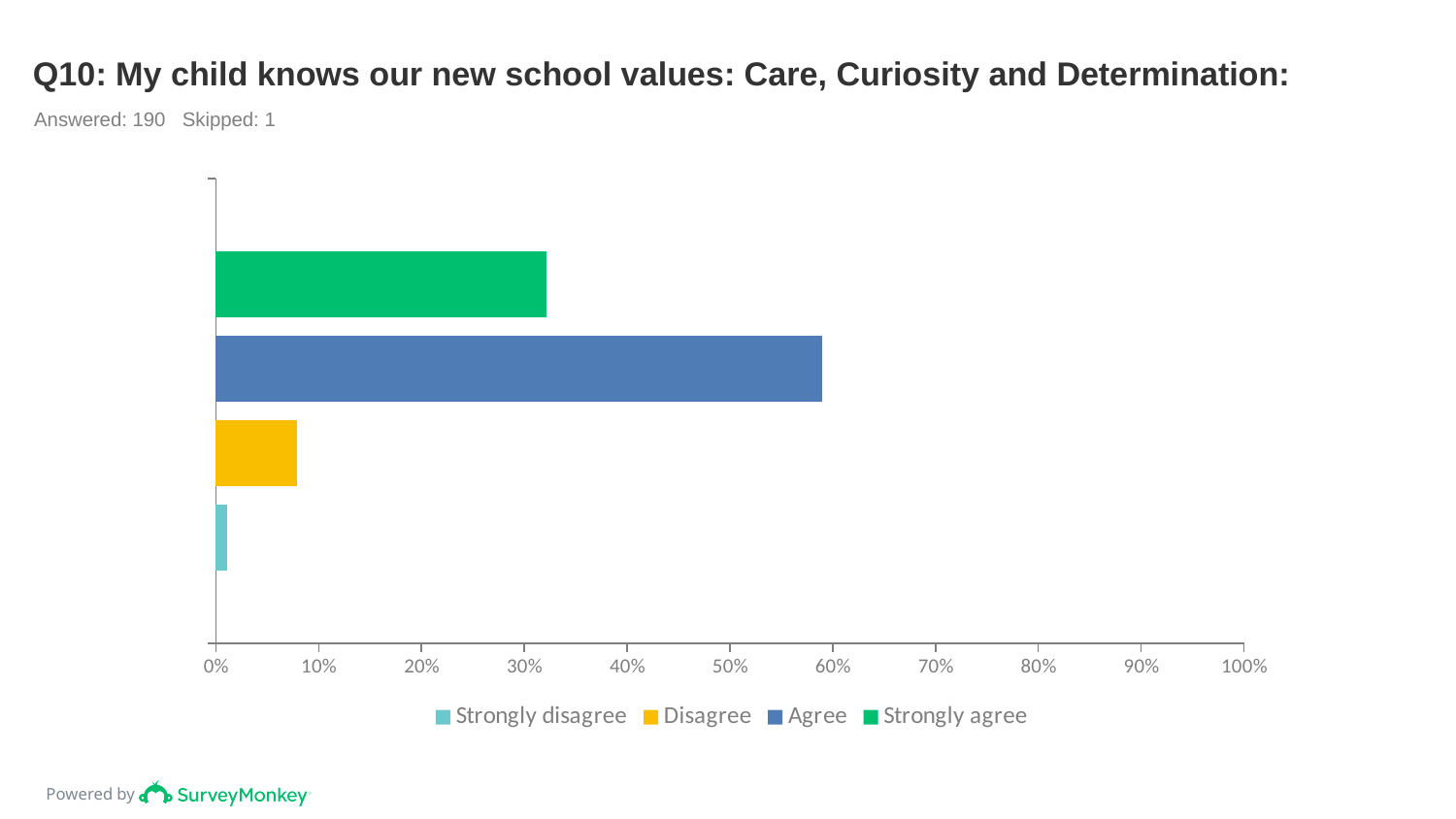
How many series does the legend list? 4 Is the value for Disagree greater or less than 10%? less How many responses were answered according to the slide? 190 Is the value for Agree greater or less than 50%? greater What kind of chart is shown on the slide? bar chart Which response option has the longest bar? Agree Which response option has the shortest bar? Strongly disagree Is the value for Strongly agree greater or less than 30%? greater Which is larger, the value for Agree or the value for Strongly agree? Agree Which is larger, the value for Disagree or the value for Strongly disagree? Disagree What colour is the bar for Strongly agree? green